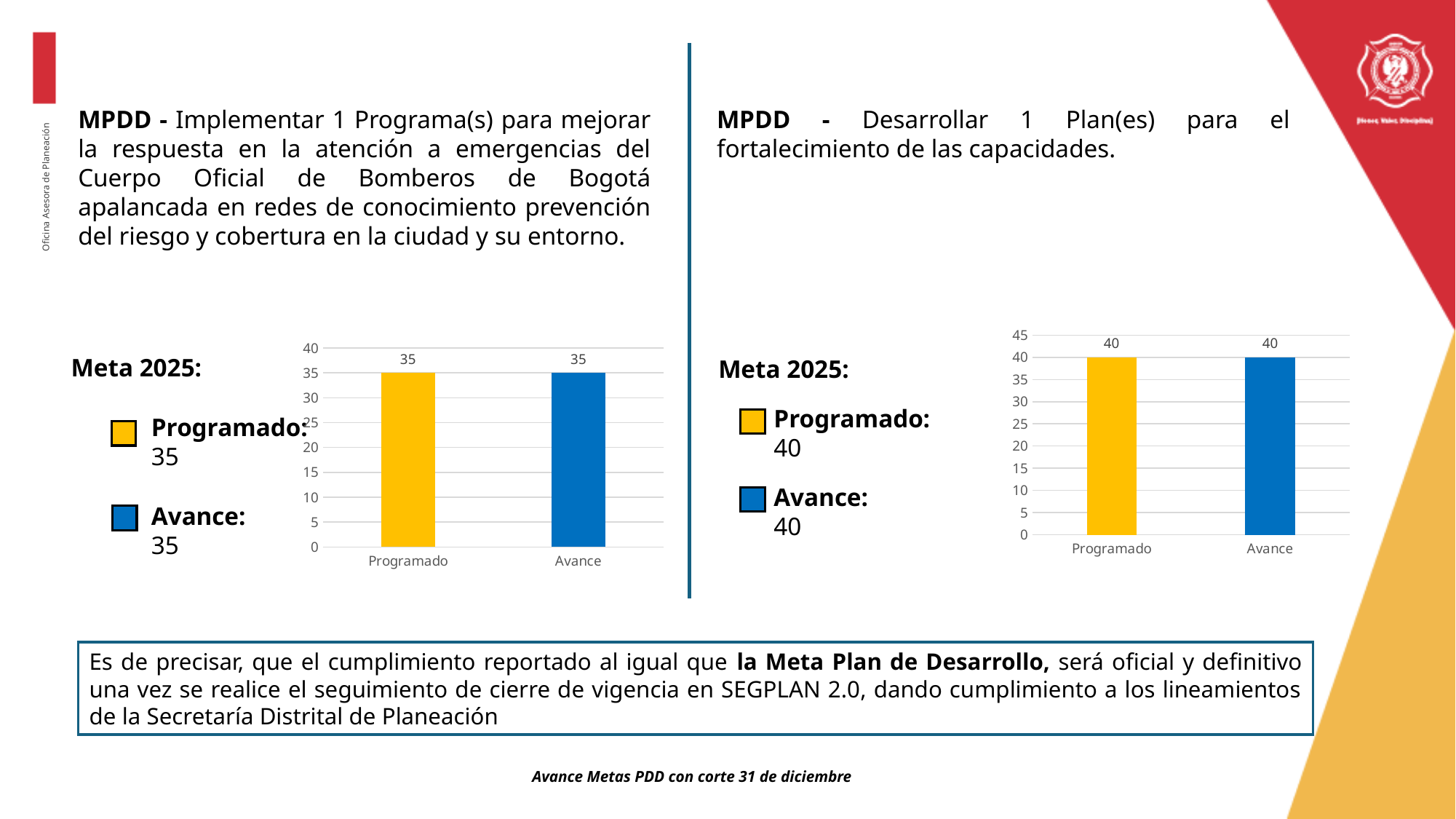
In the right chart, is the value for Avance greater or less than 35? greater In the right chart, what is the value for Programado? 40 In the left chart, what is the value for Avance? 35 What kind of chart is the left chart? Bar chart How many categories are shown on the x axis of the left chart? 2 How many bars are plotted in the right chart? 2 In the left chart, is the value for Programado greater or less than 40? less In the right chart, what is the difference between the Programado and Avance values? 0 In the left chart, what is the value for Programado? 35 In the right chart, what colour is the Programado bar? Yellow In the left chart, what is the difference between the Programado and Avance values? 0 In the right chart, what is the value for Avance? 40